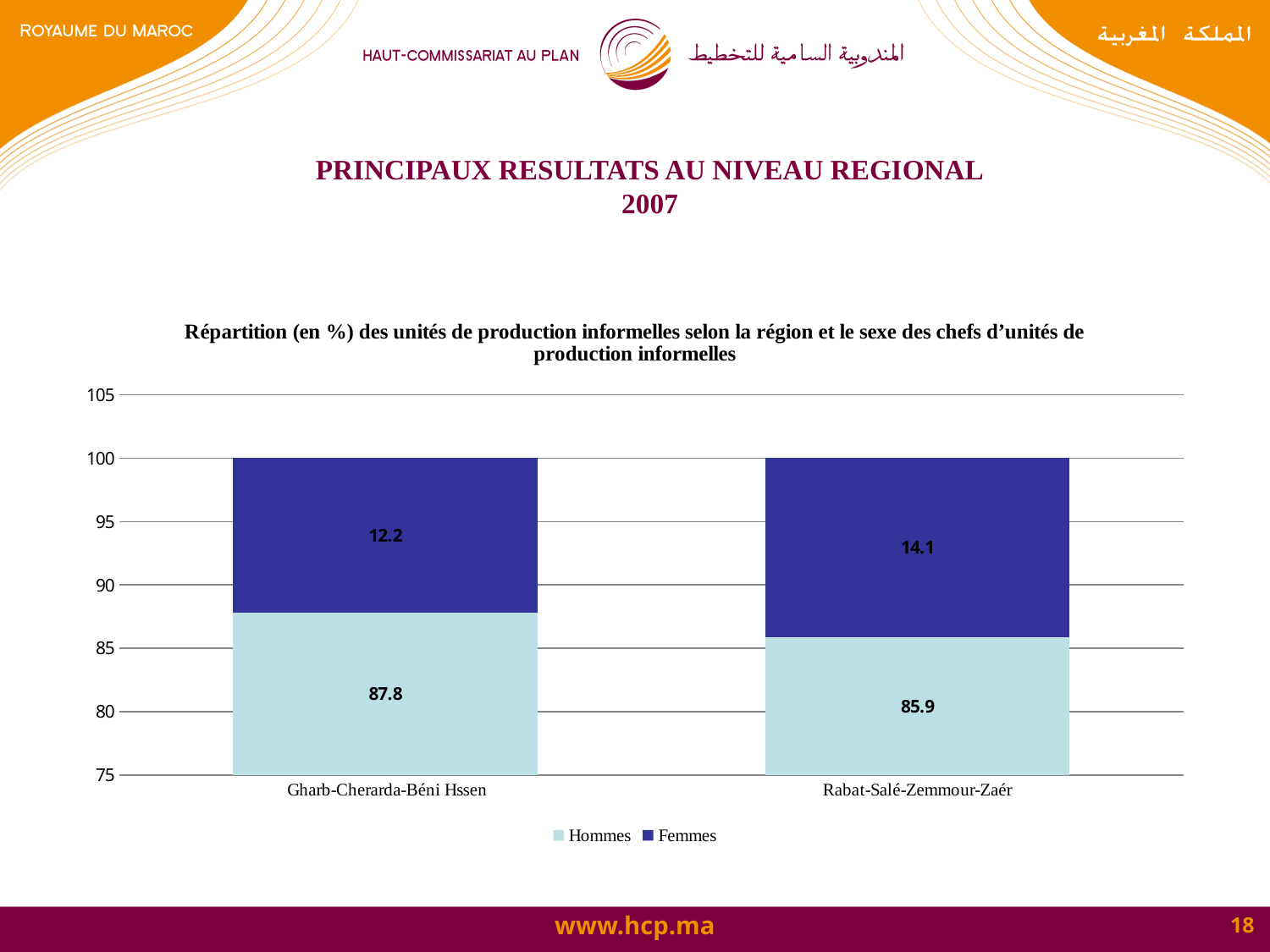
What kind of chart is shown on the slide? Stacked bar chart What is the total of the stacked bar for Rabat-Salé-Zemmour-Zaér? 100 What is the Hommes value for Rabat-Salé-Zemmour-Zaér? 85.9 How many series does the legend list? 2 What is the Hommes value for Gharb-Cherarda-Béni Hssen? 87.8 What is the Femmes value for Gharb-Cherarda-Béni Hssen? 12.2 Is the Hommes value for Gharb-Cherarda-Béni Hssen larger than the Hommes value for Rabat-Salé-Zemmour-Zaér? Yes What is the difference between the Hommes values of Gharb-Cherarda-Béni Hssen and Rabat-Salé-Zemmour-Zaér? 1.9 What is the Femmes value for Rabat-Salé-Zemmour-Zaér? 14.1 Which region has the higher Femmes value? Rabat-Salé-Zemmour-Zaér Which region has the lower Hommes value? Rabat-Salé-Zemmour-Zaér How many regions are shown on the x axis? 2